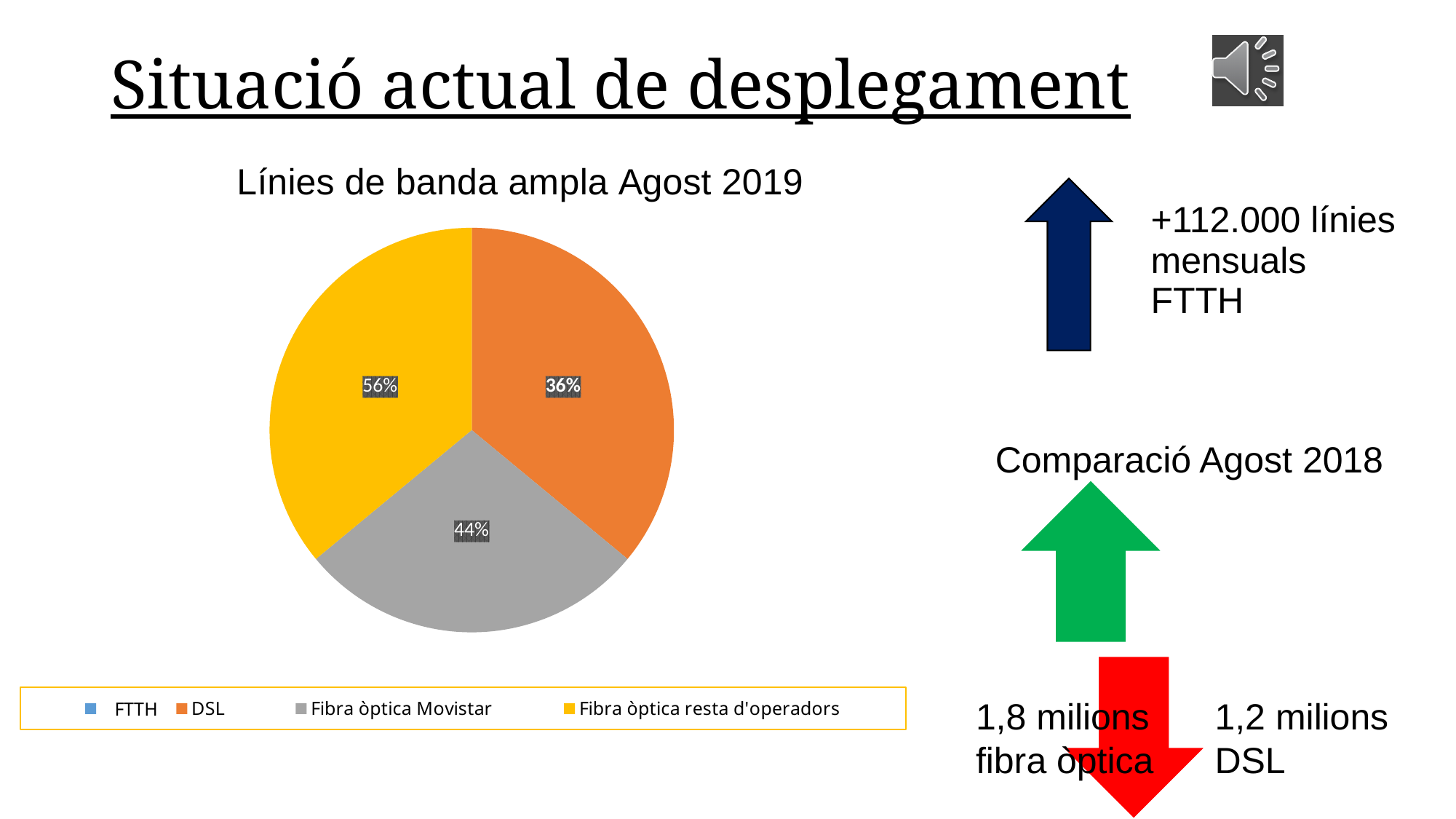
What kind of chart is shown on the slide? pie chart What colour is the Fibra òptica resta d'operadors slice? yellow How many entries does the legend list? 4 What is the difference in percentage points between the Fibra òptica resta d'operadors slice and the DSL slice? 20 What percentage is shown for the Fibra òptica resta d'operadors slice? 56% Which slice has the highest percentage label? Fibra òptica resta d'operadors What is the difference in percentage points between the Fibra òptica Movistar slice and the DSL slice? 8 What percentage is shown for the DSL slice? 36% What percentage is shown for the Fibra òptica Movistar slice? 44% Which slice has the lowest percentage label? DSL What is the title of the chart? Línies de banda ampla Agost 2019